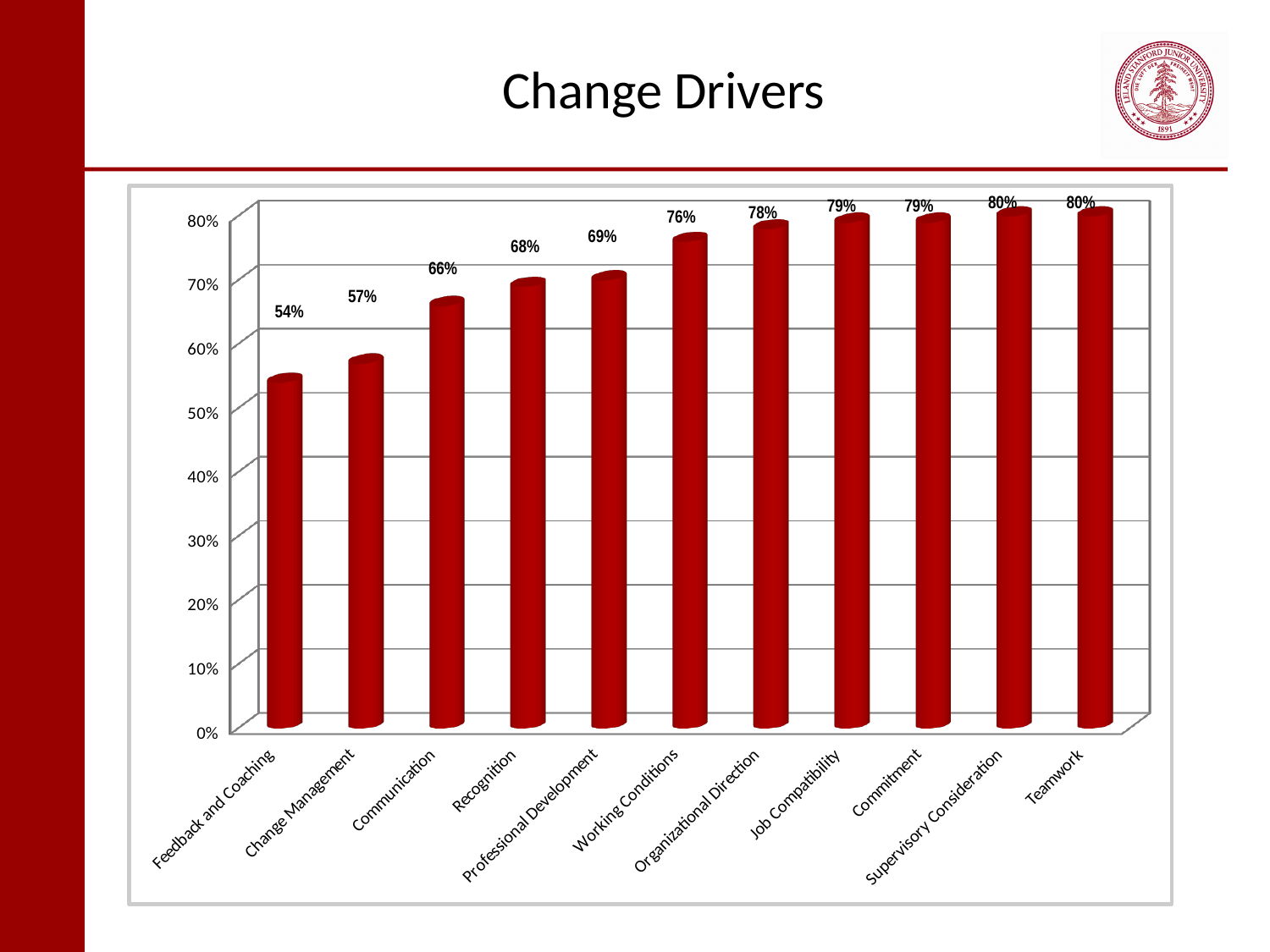
What is the value for Working Conditions? 76% Which category has the lowest value? Feedback and Coaching Which is larger, the value for Change Management or the value for Professional Development? Professional Development What kind of chart is shown on the slide? bar chart Is the value for Communication greater or less than 60%? greater What is the value for Supervisory Consideration? 80% How many categories are shown on the x axis? 11 What is the difference between the values for Organizational Direction and Communication? 12% What is the value for Feedback and Coaching? 54% What is the value for Recognition? 68% Do the values rise or fall from left to right along the x axis? rise What is the difference between the values for Teamwork and Feedback and Coaching? 26%